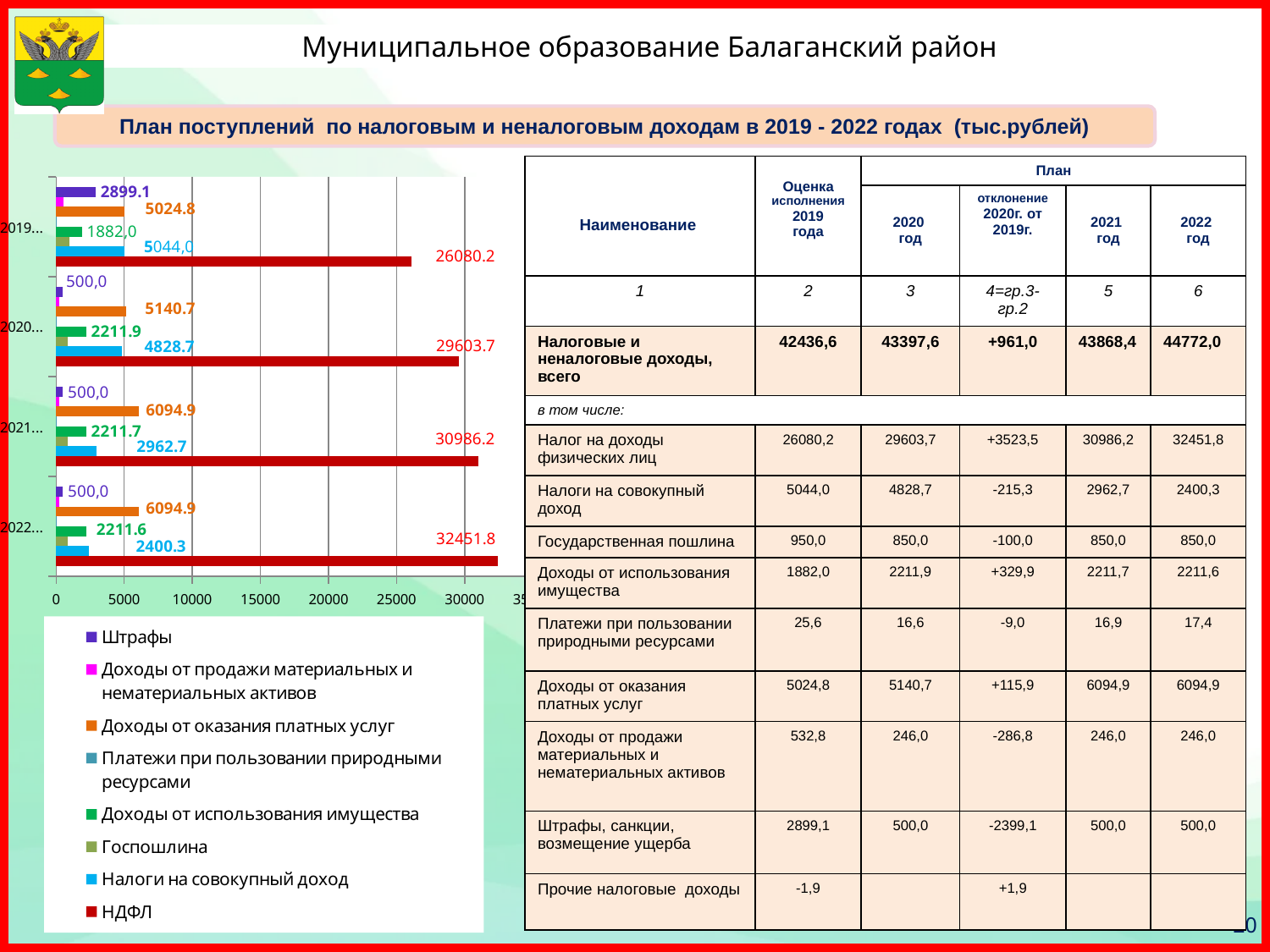
What is the value of Доходы от оказания платных услуг for 2021 on the chart? 6094.9 Which is larger on the chart: Налоги на совокупный доход for 2019 or for 2020? 2019 How many year categories are plotted on the chart? 4 In which year is the НДФЛ value highest on the chart? 2022 What kind of chart is shown on the slide? bar chart What is the value of Штрафы for 2019 on the chart? 2899.1 Does the НДФЛ value rise or fall from 2019 to 2022 on the chart? rise Which series is shown in dark red on the chart? НДФЛ How many series does the chart legend list? 8 What is the difference between the НДФЛ values for 2022 and 2021 on the chart? 1465.6 What is the value of Налоги на совокупный доход for 2022 on the chart? 2400.3 What is the value of НДФЛ for 2019 on the chart? 26080.2